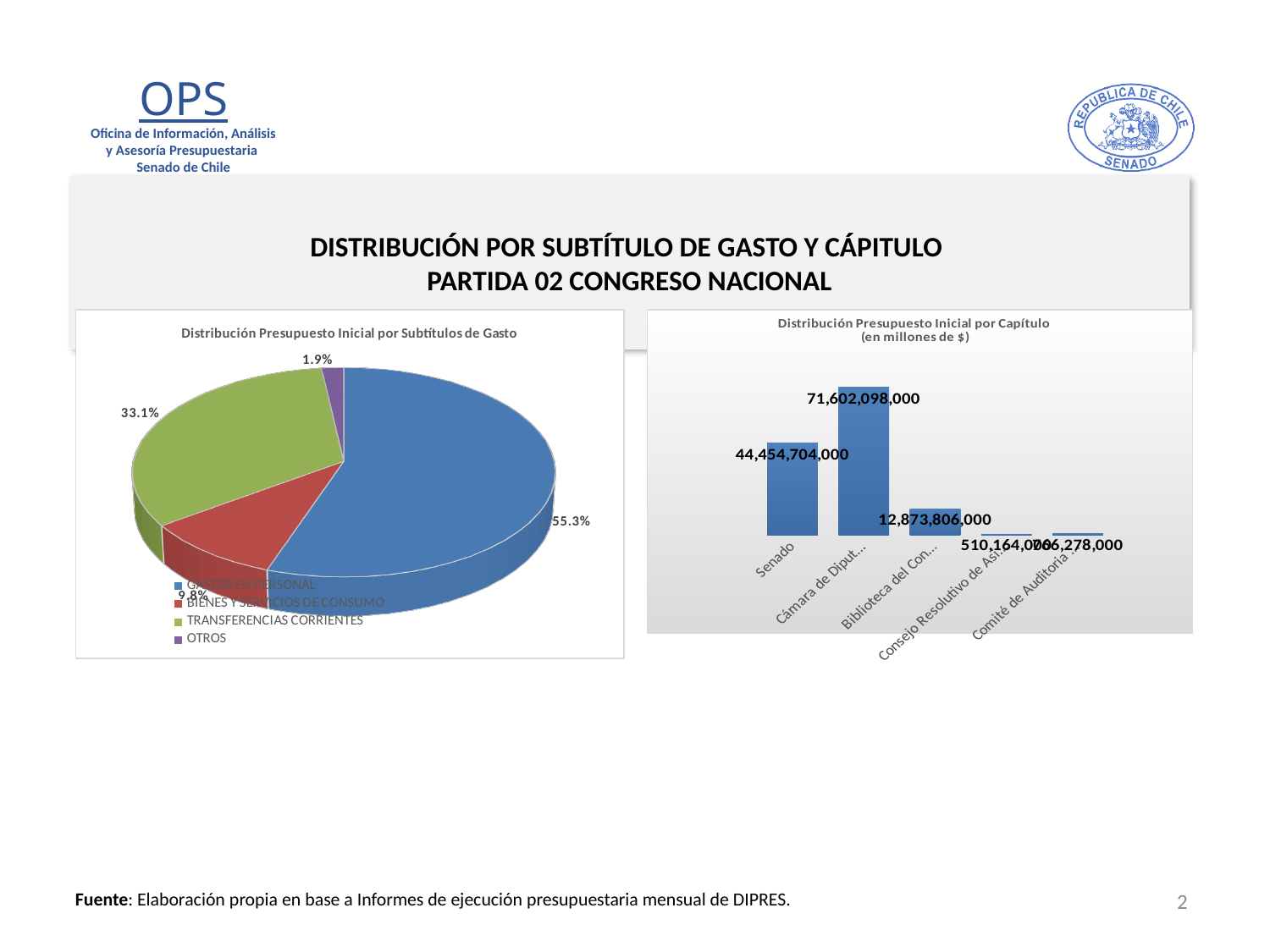
In the pie chart 'Distribución Presupuesto Inicial por Subtítulos de Gasto', which category has the smallest slice? OTROS How many categories are shown in the bar chart 'Distribución Presupuesto Inicial por Capítulo'? 5 In the bar chart 'Distribución Presupuesto Inicial por Capítulo', what is the value for Senado? 44,454,704,000 In the bar chart 'Distribución Presupuesto Inicial por Capítulo', what is the value for Biblioteca del Con...? 12,873,806,000 In the pie chart 'Distribución Presupuesto Inicial por Subtítulos de Gasto', what share does TRANSFERENCIAS CORRIENTES have? 33.1% What kind of chart is the chart on the left of the slide? Pie chart In the pie chart 'Distribución Presupuesto Inicial por Subtítulos de Gasto', what share does GASTOS EN PERSONAL have? 55.3% In the bar chart 'Distribución Presupuesto Inicial por Capítulo', what is the value for Cámara de Diput...? 71,602,098,000 In the bar chart 'Distribución Presupuesto Inicial por Capítulo', what is the difference between the values for Cámara de Diput... and Senado? 27,147,394,000 In the pie chart 'Distribución Presupuesto Inicial por Subtítulos de Gasto', what share does OTROS have? 1.9% In the pie chart 'Distribución Presupuesto Inicial por Subtítulos de Gasto', which category has the largest slice? GASTOS EN PERSONAL How many entries does the legend of the pie chart 'Distribución Presupuesto Inicial por Subtítulos de Gasto' list? 4